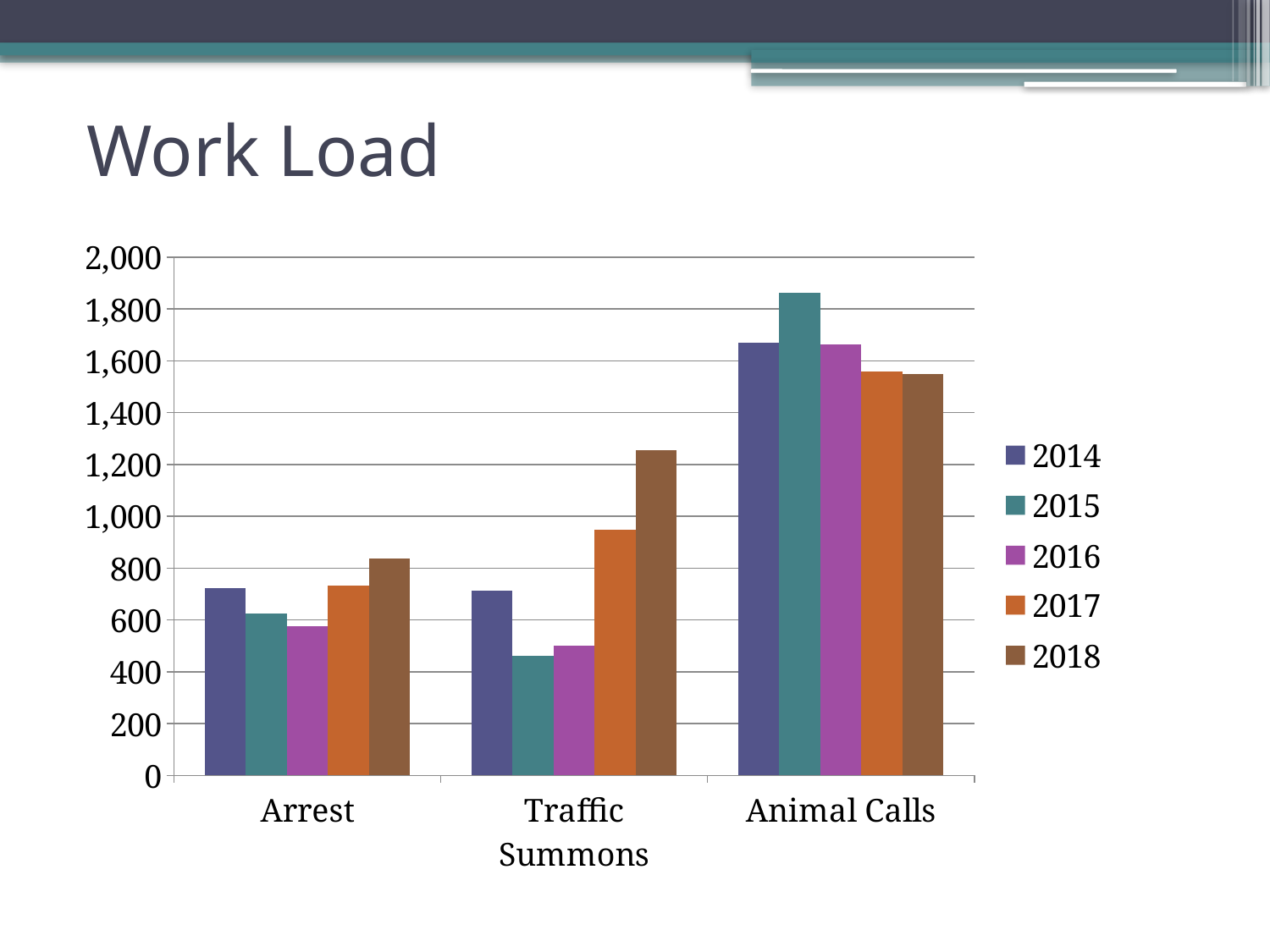
Which year has the highest value for Traffic Summons? 2018 Which year has the lowest value for Traffic Summons? 2015 Which is larger for Arrest: the value for 2014 or the value for 2018? 2018 Is the value for Traffic Summons in 2018 greater or less than 1,200? greater Is the value for Animal Calls in 2015 greater or less than 1,800? greater How many categories are shown on the x axis? 3 Is the value for Traffic Summons in 2015 greater or less than 600? less What is the title of the slide containing the chart? Work Load What kind of chart is shown on the slide? bar chart How many series does the legend list? 5 Which year has the highest value for Animal Calls? 2015 Which year has the lowest value for Arrest? 2016